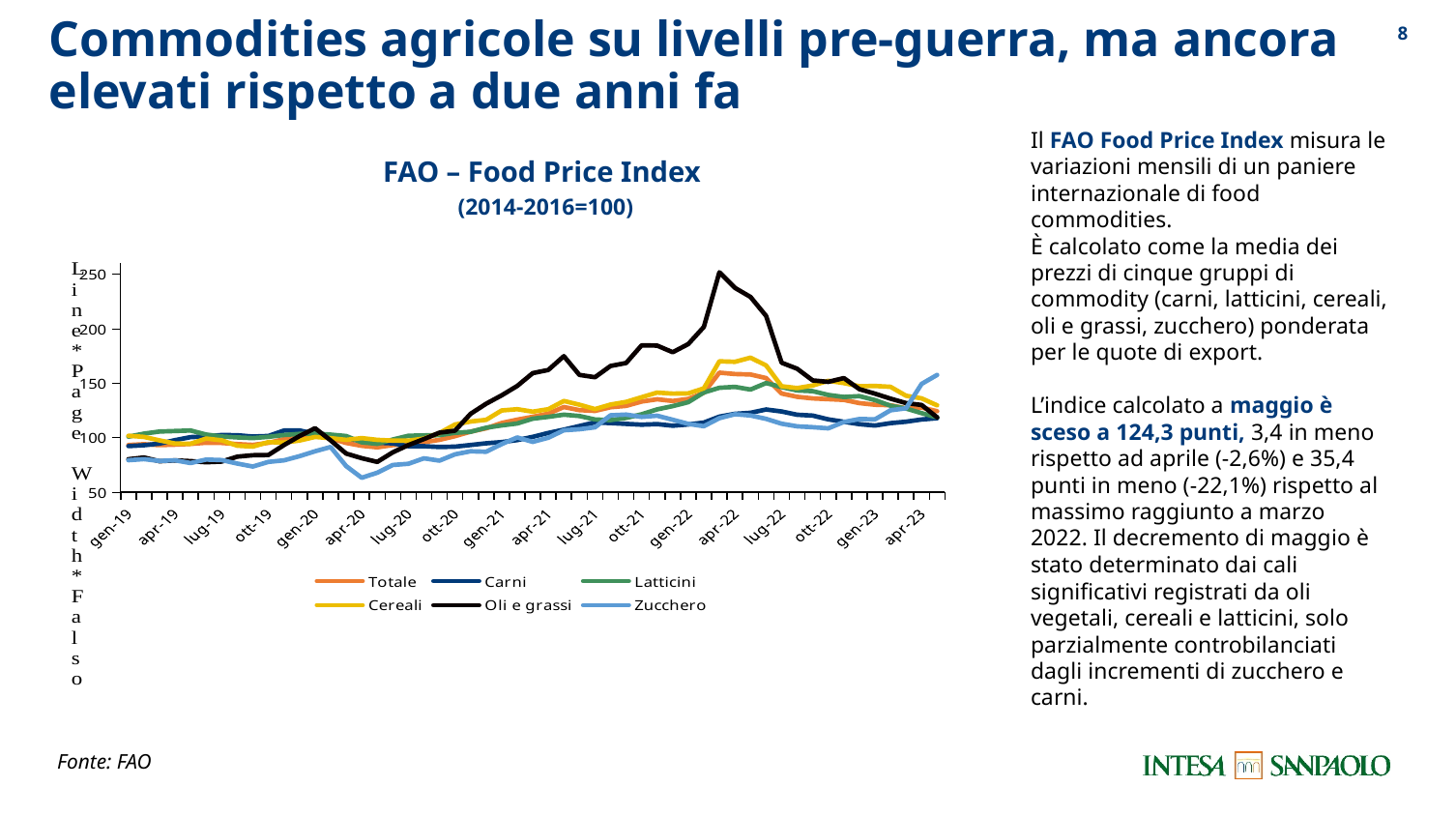
What kind of chart is shown on the slide? line chart How many date labels are shown on the x axis of the chart? 18 Is the value of the Oli e grassi series at apr-20 greater or less than 100? less Does the Oli e grassi series rise or fall between apr-22 and apr-23? fall What base period is shown under the chart title FAO – Food Price Index? 2014-2016=100 Which series has the highest value at apr-23, Zucchero or Cereali? Zucchero Does the Zucchero series rise or fall between ott-22 and apr-23? rise Is the value of the Zucchero series at gen-19 greater or less than 100? less Which series reaches the highest value anywhere on the FAO – Food Price Index chart? Oli e grassi How many series does the legend of the FAO – Food Price Index chart list? 6 Is the peak value of the Oli e grassi series greater or less than 200? greater